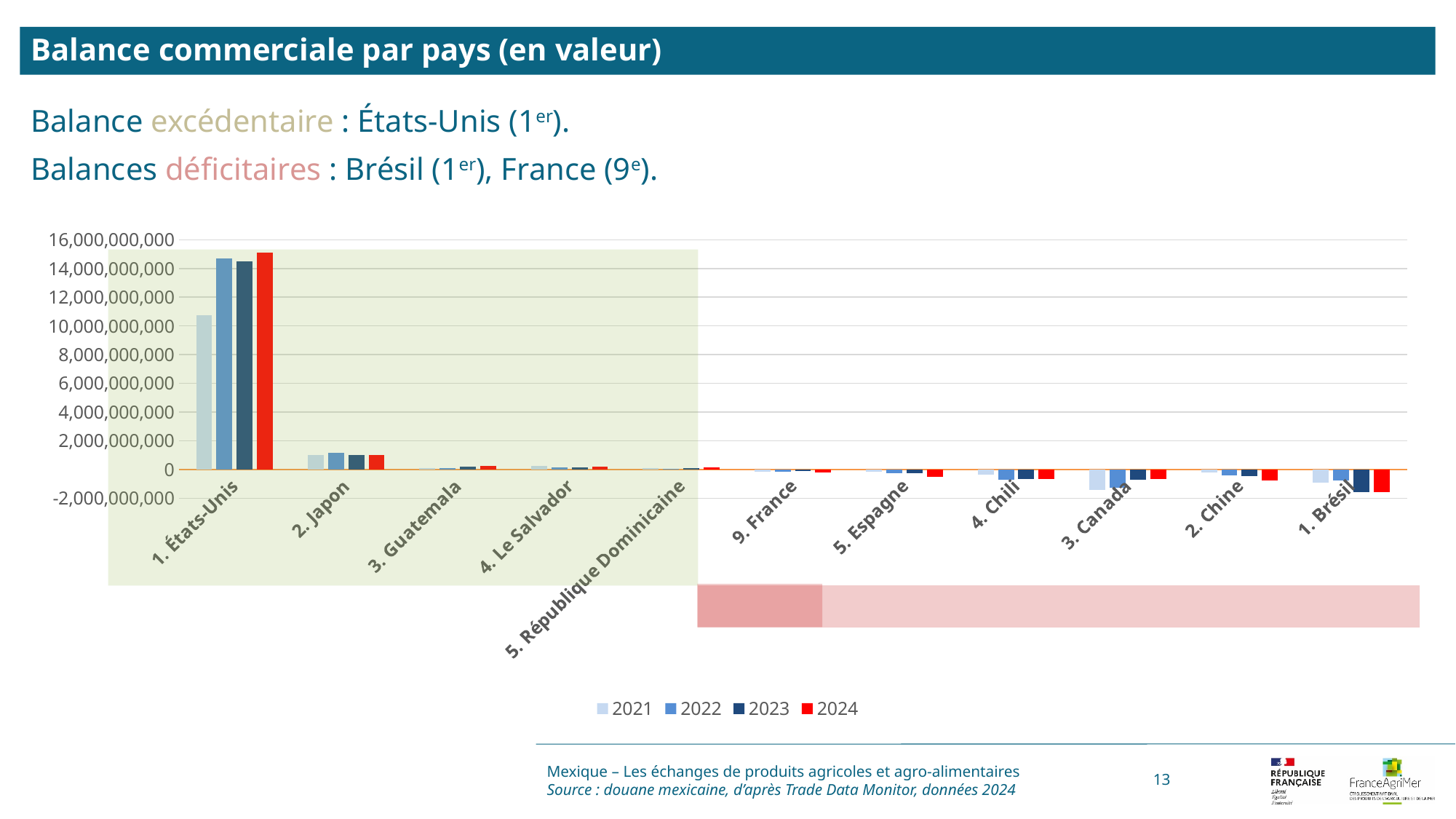
Is the 2024 value for 2. Japon greater or less than 2,000,000,000? less Is the 2024 value for 1. Brésil greater or less than 0? less For 1. États-Unis, which is larger: the 2021 value or the 2024 value? 2024 How many series does the legend list? 4 Is the 2024 value for 1. États-Unis greater or less than 14,000,000,000? greater How many countries are shown on the x axis of the chart? 11 What is the title of the chart on the slide? Balance commerciale par pays (en valeur) Which country has the highest value for 2024? 1. États-Unis Which country has the lowest (most negative) value for 2024? 1. Brésil Which colour represents the 2024 series in the legend? Red What kind of chart is shown on the slide? Bar chart